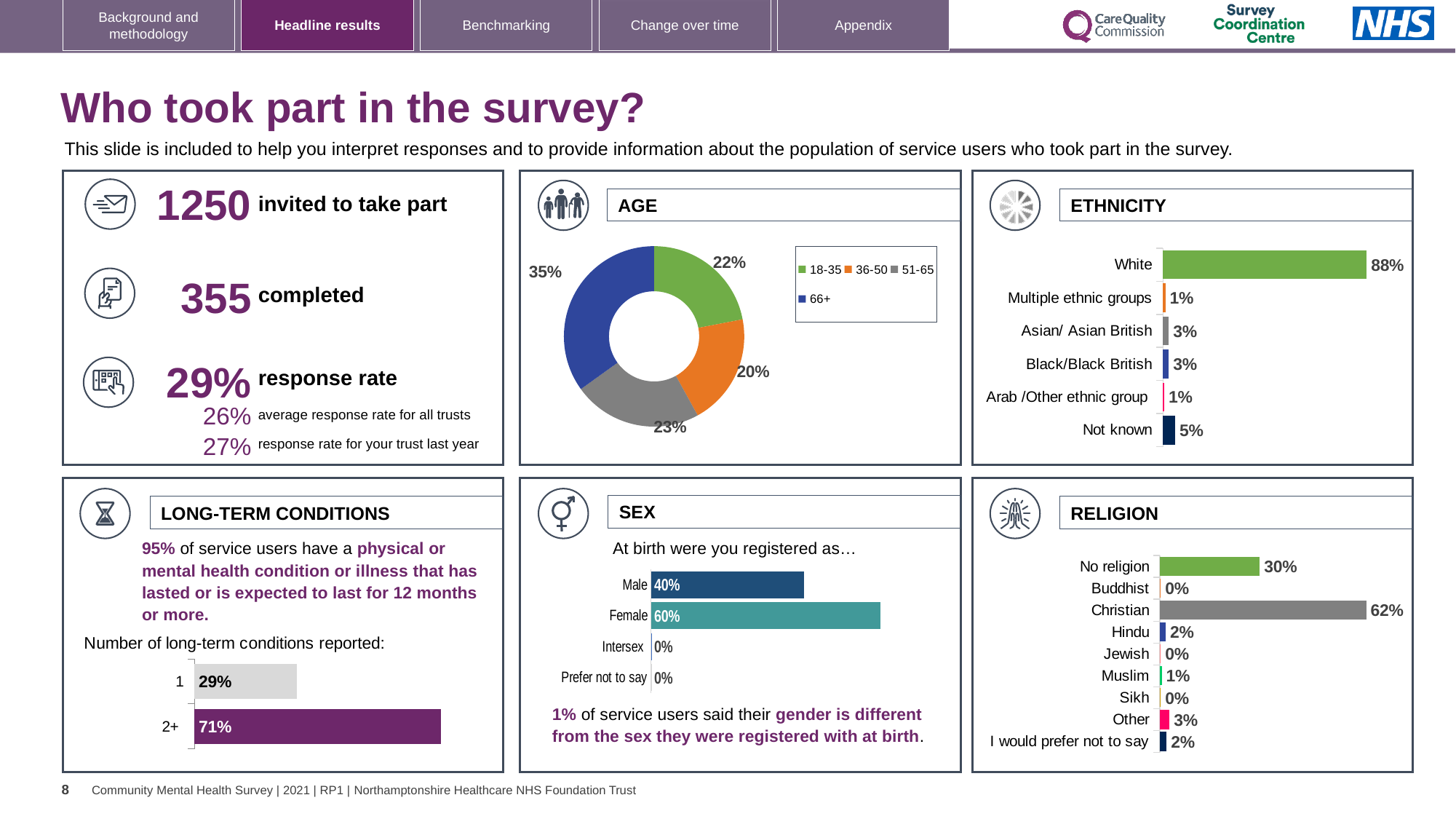
In the RELIGION chart, what is the value for No religion? 30% What kind of chart is the AGE chart? Donut chart In the SEX chart, what is the difference between Female and Male? 20% In the AGE chart, which age group has the smallest share? 36-50 In the RELIGION chart, which category has the highest value? Christian In the AGE chart, what percentage of respondents were aged 66+? 35% In the LONG-TERM CONDITIONS chart, what percentage reported 2+ conditions? 71% In the ETHNICITY chart, what is the difference between White and Not known? 83% In the ETHNICITY chart, what is the value for White? 88% How many age groups does the legend of the AGE chart list? 4 In the SEX chart, which is larger, Male or Female? Female How many ethnicity categories are shown in the ETHNICITY chart? 6